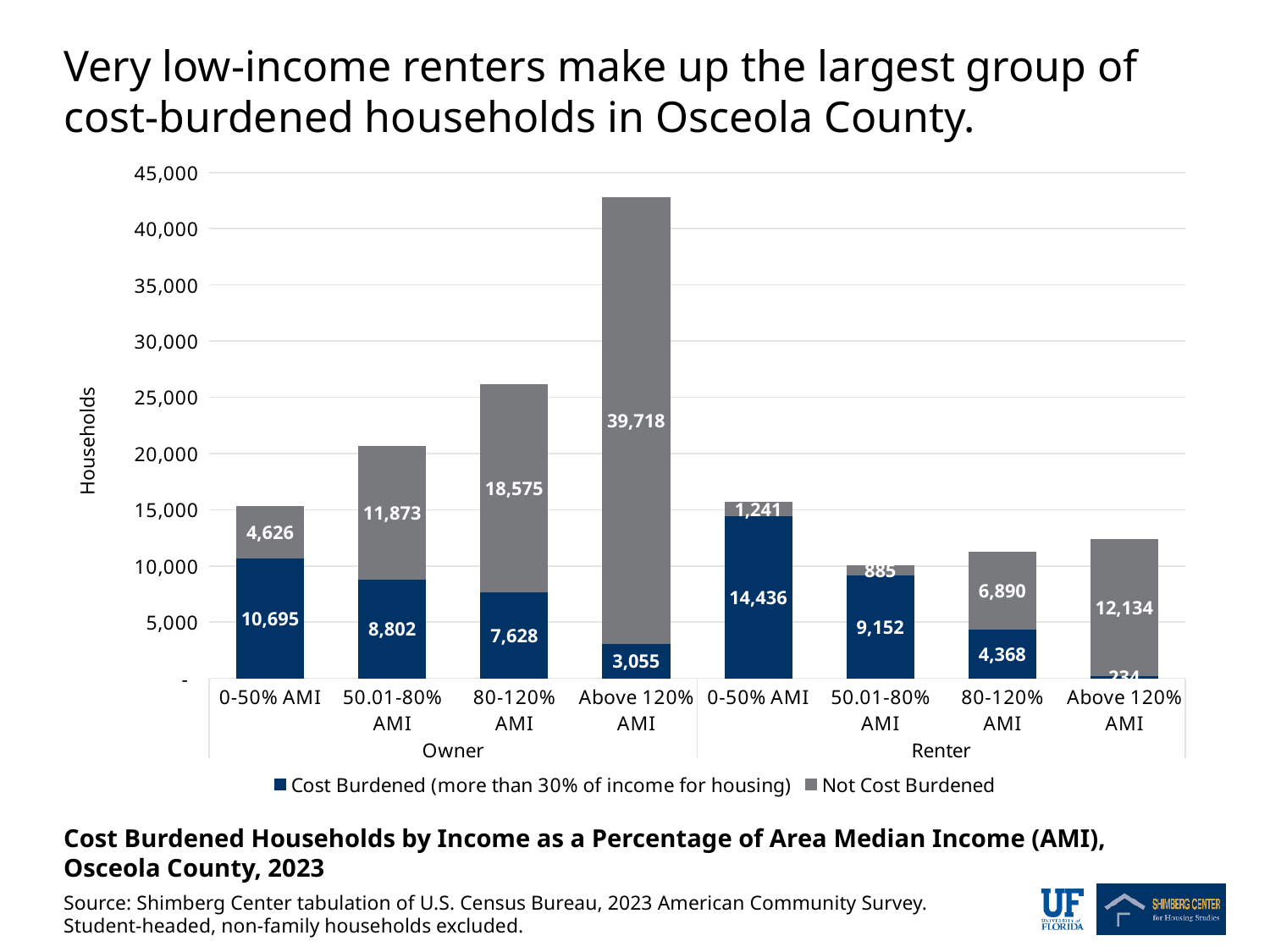
How many not-cost-burdened households are there among owners above 120% AMI? 39,718 What is the total number of households (cost burdened plus not cost burdened) for owners at 80-120% AMI? 26,203 How many series does the legend list? 2 Is the total bar height for owners above 120% AMI greater or less than 40,000? greater Which is larger: the number of cost-burdened owners at 50.01-80% AMI or cost-burdened renters at 50.01-80% AMI? Renters at 50.01-80% AMI Which category has the highest number of cost-burdened households? Renter 0-50% AMI How many cost-burdened households are there among owners at 80-120% AMI? 7,628 How many cost-burdened households are there among renters at 0-50% AMI? 14,436 What type of chart is shown on the slide? Stacked bar chart What is the difference between the cost-burdened households for renters at 0-50% AMI and owners at 0-50% AMI? 3,741 How many income categories are shown across both the Owner and Renter groups? 8 Which category has the lowest number of not-cost-burdened households? Renter 50.01-80% AMI